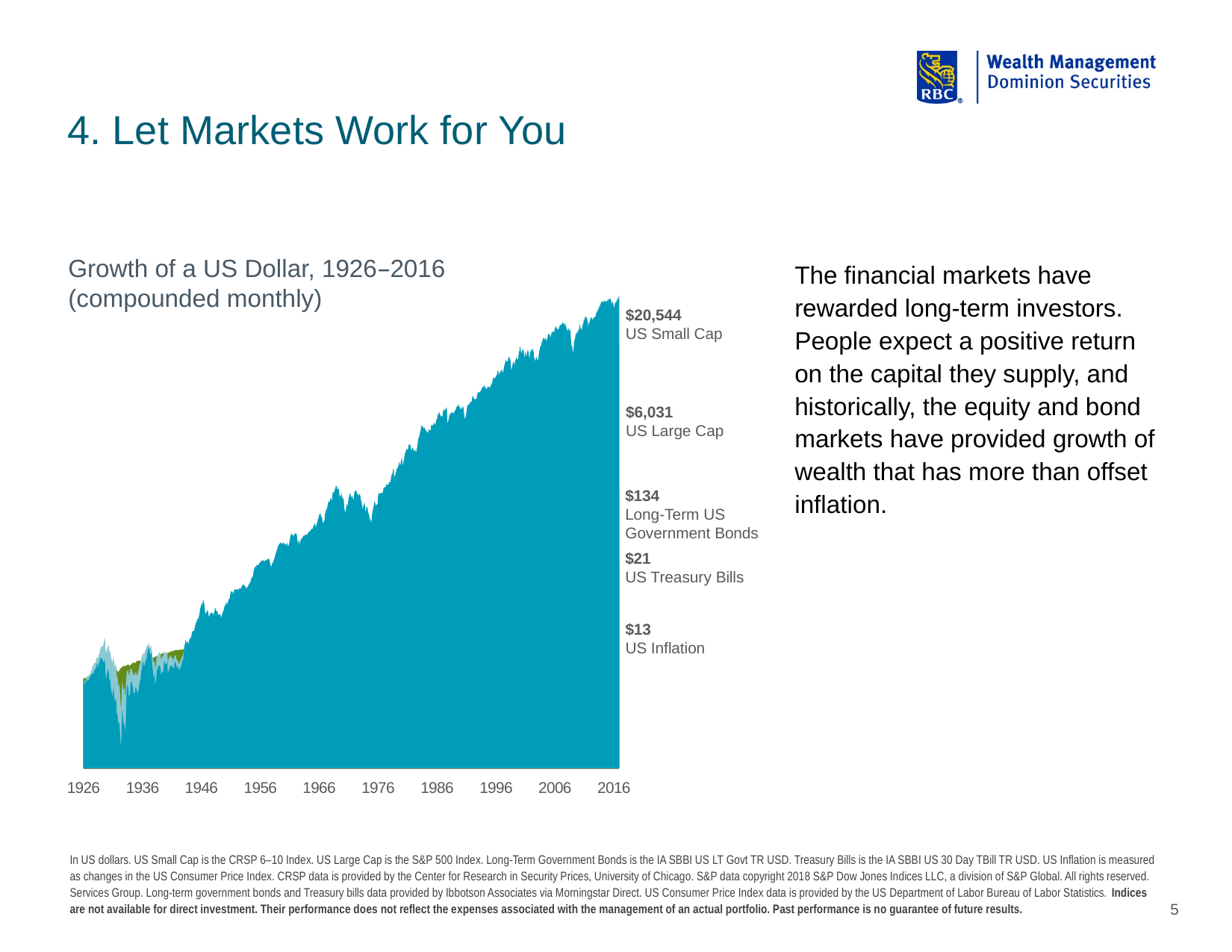
What is the 2016 ending value shown for US Large Cap? $6,031 Which series has the lowest ending value in 2016? US Inflation Which series has the highest ending value in 2016? US Small Cap What is the ending value shown for Long-Term US Government Bonds? $134 What is the title of the chart? Growth of a US Dollar, 1926–2016 (compounded monthly) What is the difference between the ending values of US Small Cap and US Large Cap? $14,513 Which has a larger ending value, Long-Term US Government Bonds or US Treasury Bills? Long-Term US Government Bonds How many series are labelled on the chart? 5 What is the 2016 ending value shown for US Small Cap? $20,544 What is the difference between the ending values of US Treasury Bills and US Inflation? $8 What is the ending value shown for US Inflation? $13 What is the ending value shown for US Treasury Bills? $21